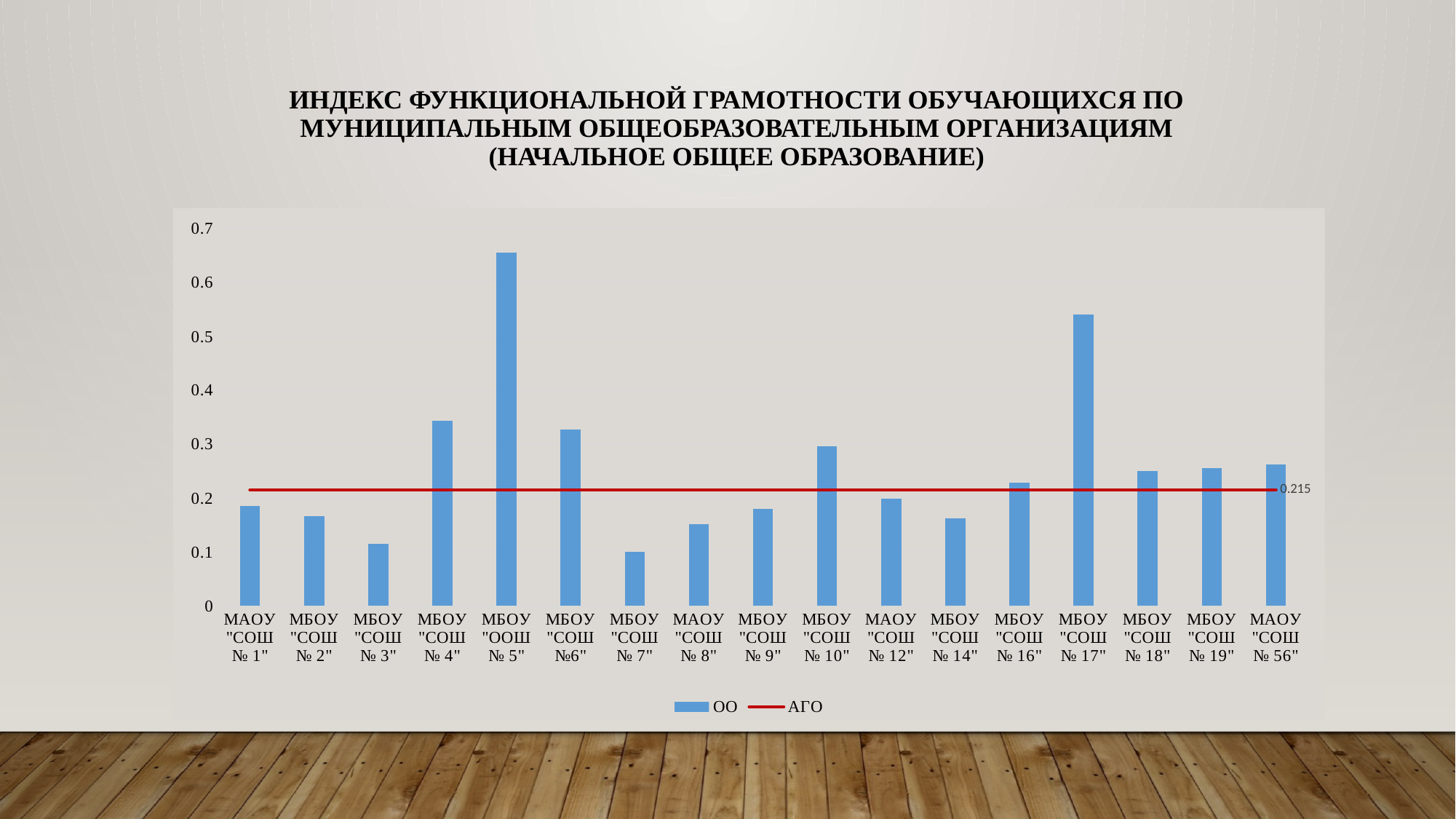
Is the value for МБОУ "СОШ № 4" greater or less than 0.3? greater What are the two entries listed in the legend? ОО and АГО What kind of chart is shown on the slide? Bar chart with a line Is the value for МБОУ "СОШ № 3" greater or less than 0.2? less What value is printed for the АГО line on the chart? 0.215 Which organisation has the highest index value on the chart? МБОУ "ООШ № 5" How many organisations (categories) are shown on the x axis? 17 Which has the larger value: МБОУ "ООШ № 5" or МБОУ "СОШ № 17"? МБОУ "ООШ № 5" Which organisation has the lowest index value on the chart? МБОУ "СОШ № 7" How many series does the legend list? 2 Is the value for МБОУ "СОШ № 17" greater or less than 0.5? greater